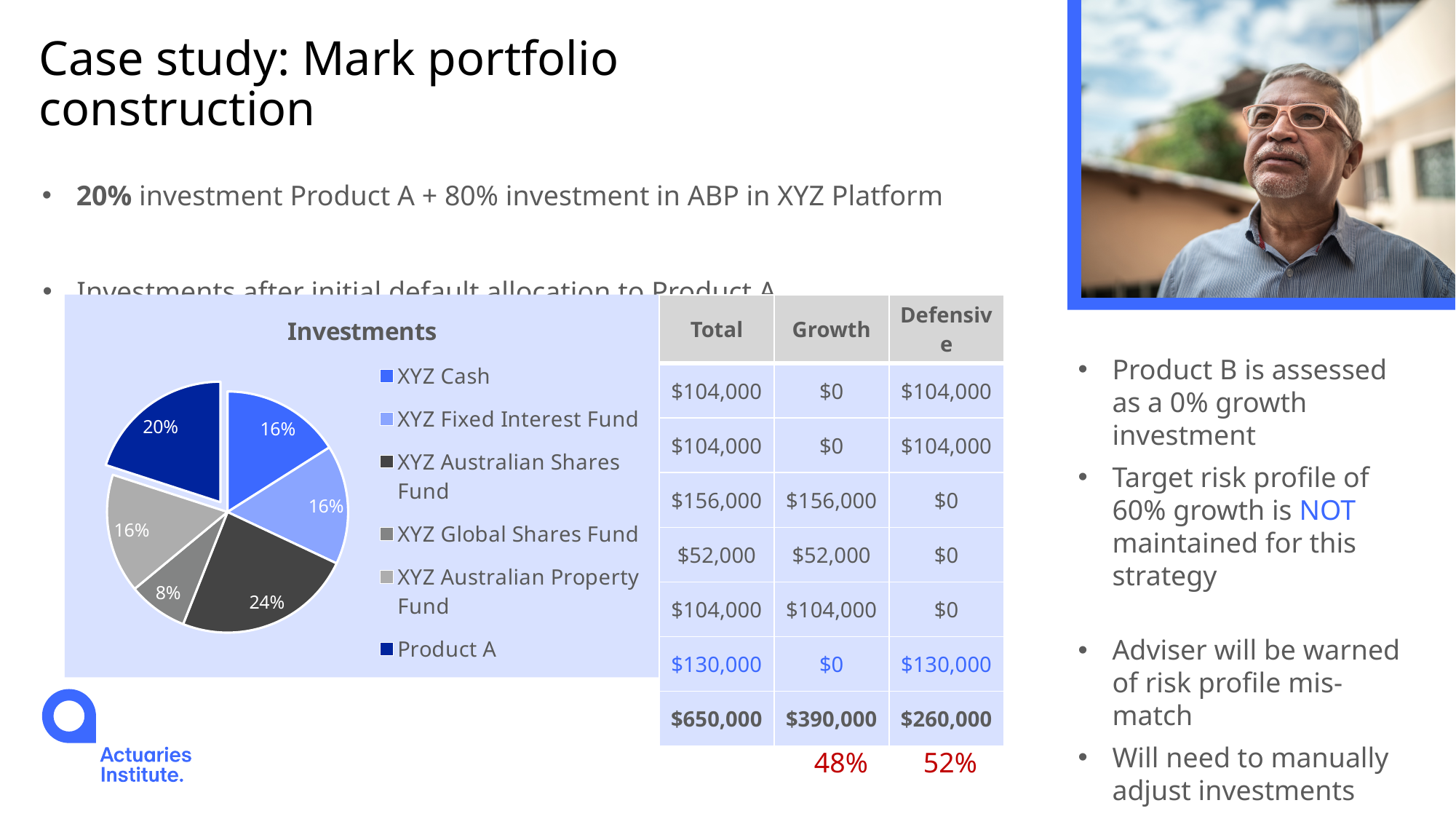
What is the difference in percentage points between XYZ Australian Shares Fund and XYZ Global Shares Fund? 16 percentage points What is the title of the chart? Investments What share of the pie does XYZ Australian Shares Fund represent? 24% Which is larger, the slice for Product A or the slice for XYZ Fixed Interest Fund? Product A Which category has the largest slice of the pie? XYZ Australian Shares Fund Which category has the smallest slice of the pie? XYZ Global Shares Fund What share of the pie does Product A represent? 20% Which slice is pulled out (exploded) from the rest of the pie? Product A How many slices does the pie chart have? 6 What is the value shown for XYZ Global Shares Fund? 8% What is the value shown for XYZ Cash? 16% What type of chart is shown on the slide? Pie chart